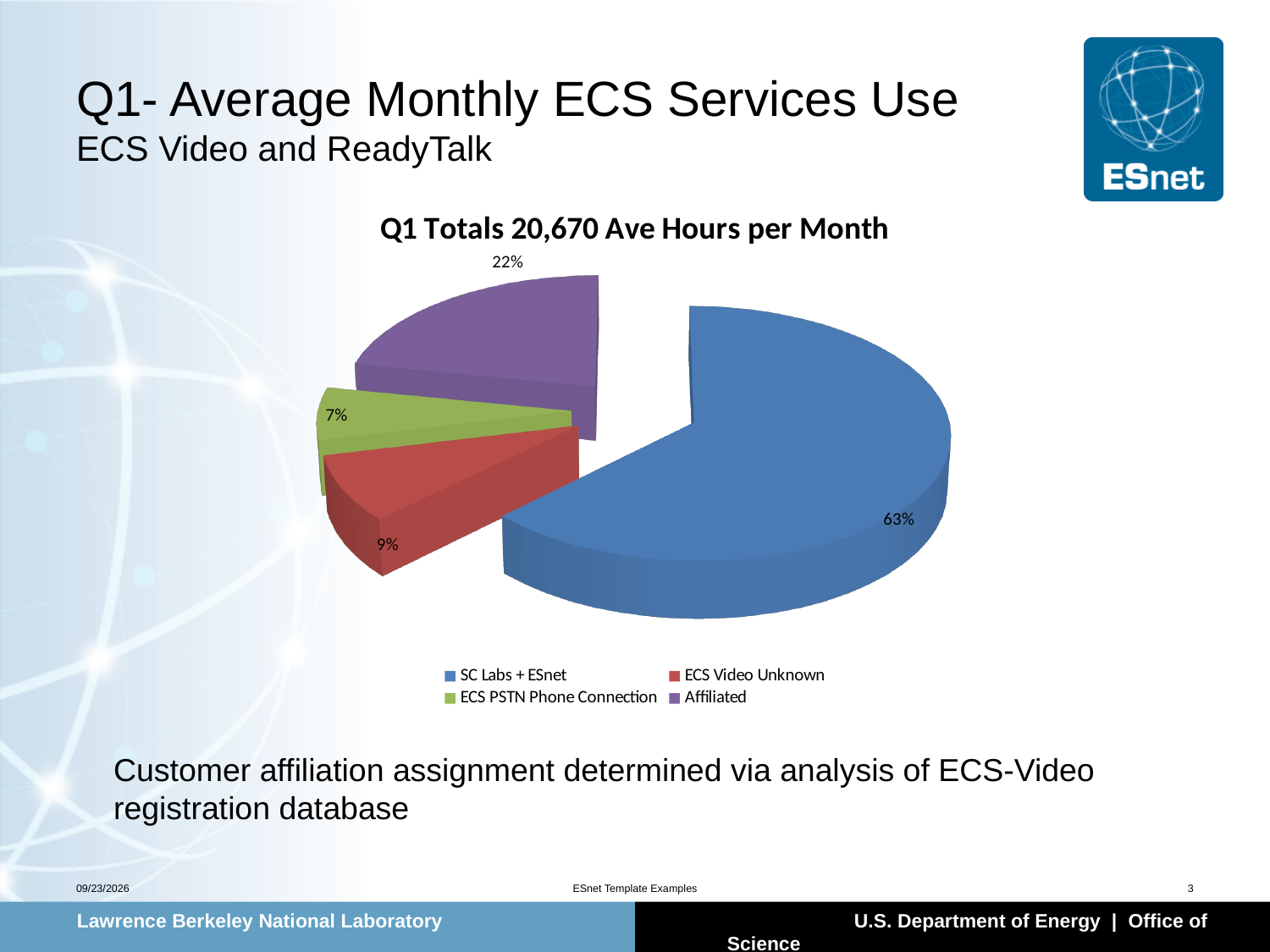
Which category has the smallest slice of the pie? ECS PSTN Phone Connection Which category has the largest slice of the pie? SC Labs + ESnet What share of the pie does SC Labs + ESnet account for? 63% How many slices does the pie chart have? 4 Which slice is larger, ECS Video Unknown or ECS PSTN Phone Connection? ECS Video Unknown What share of the pie does ECS Video Unknown account for? 9% What kind of chart is shown on the slide? Pie chart What share of the pie does ECS PSTN Phone Connection account for? 7% What is the difference in percentage points between the SC Labs + ESnet slice and the Affiliated slice? 41 Which colour represents the Affiliated category in the pie chart? Purple What is the title of the chart? Q1 Totals 20,670 Ave Hours per Month